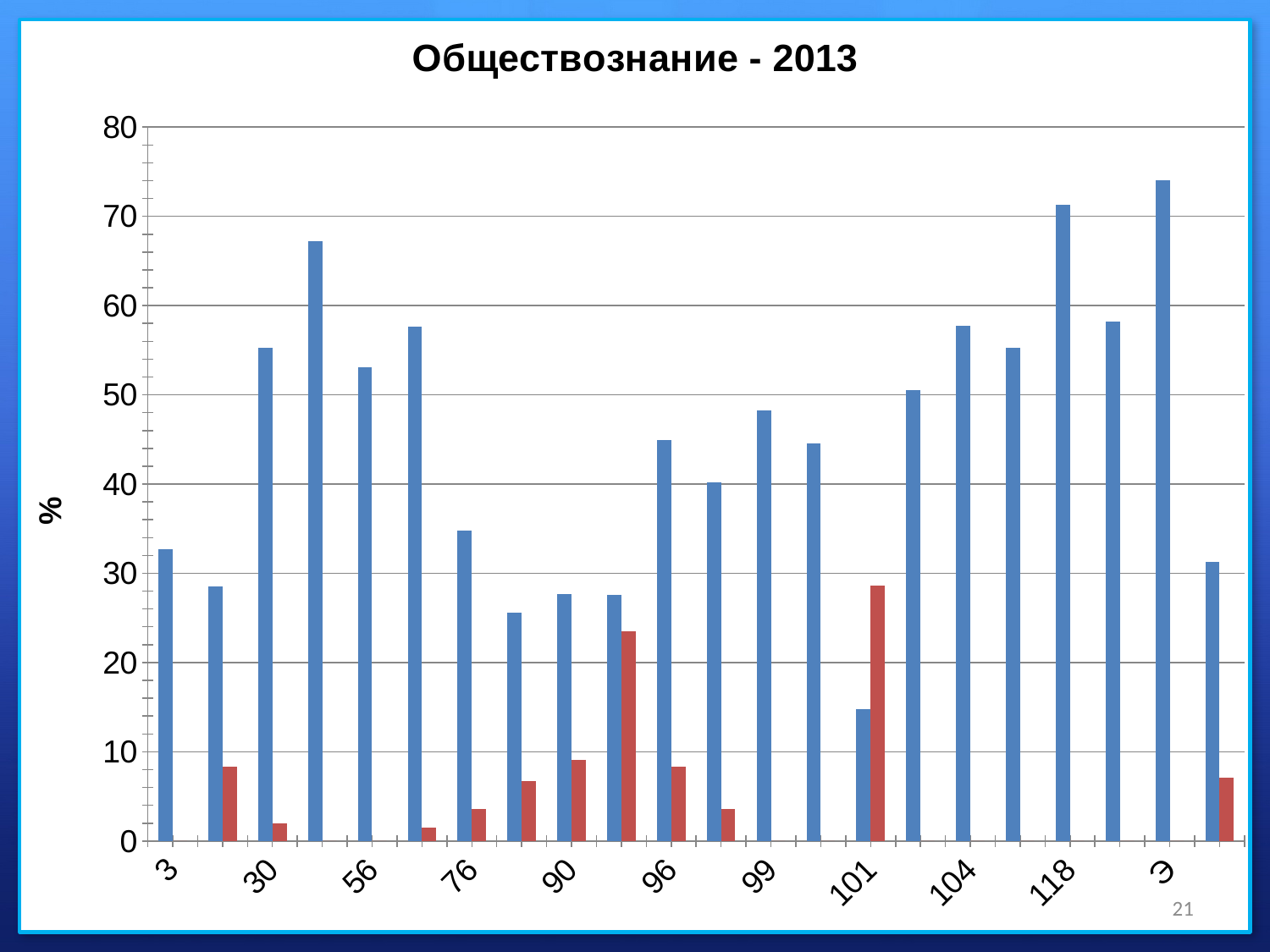
Which labeled category has the tallest blue bar? Э What is the title of the chart? Обществознание - 2013 What label is shown on the vertical axis? % What kind of chart is shown on the slide? bar chart Is the blue bar for category 104 greater or less than 50? greater Is the blue bar for category 90 greater or less than 30? less For category 101, which bar is taller, the blue one or the red one? the red one Is the blue bar for category 3 greater or less than 30? greater Which labeled category has the shortest blue bar? 101 Which has the taller blue bar, category 30 or category 76? 30 How many category labels are printed along the x axis? 11